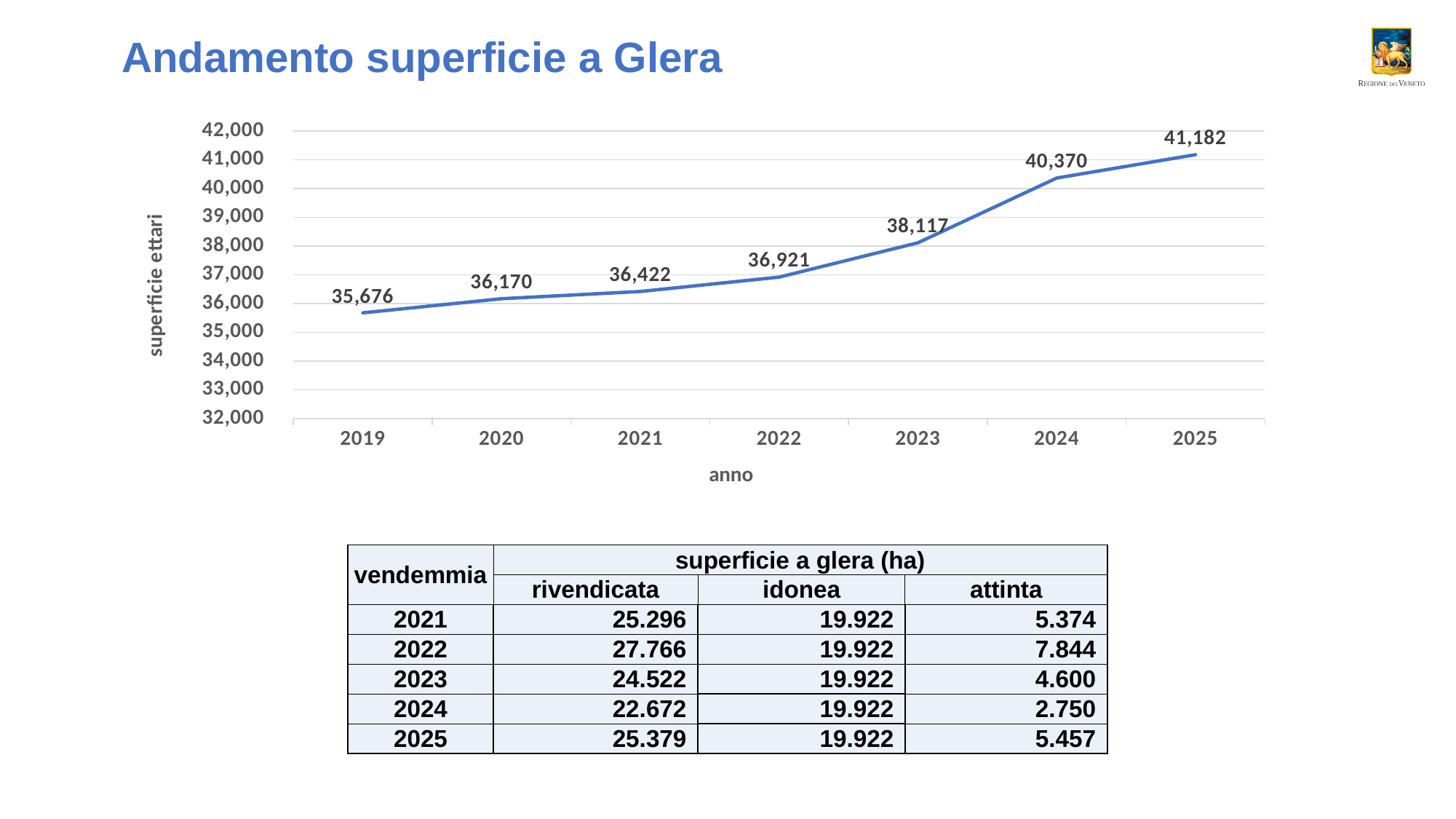
What kind of chart is shown on the slide? line chart Which year has the larger value in the line chart, 2022 or 2024? 2024 Do the values in the line chart rise or fall from 2019 to 2025? rise Is the value for 2021 in the line chart greater or less than 37,000? less What is the value plotted for 2023 in the line chart? 38,117 How many years are plotted in the line chart? 7 What is the difference between the values for 2025 and 2024 in the line chart? 812 What is the value plotted for 2025 in the line chart? 41,182 What is the value plotted for 2019 in the line chart? 35,676 Which year has the highest value in the line chart? 2025 By how much did the value increase from 2019 to 2025 in the line chart? 5,506 Which year has the lowest value in the line chart? 2019